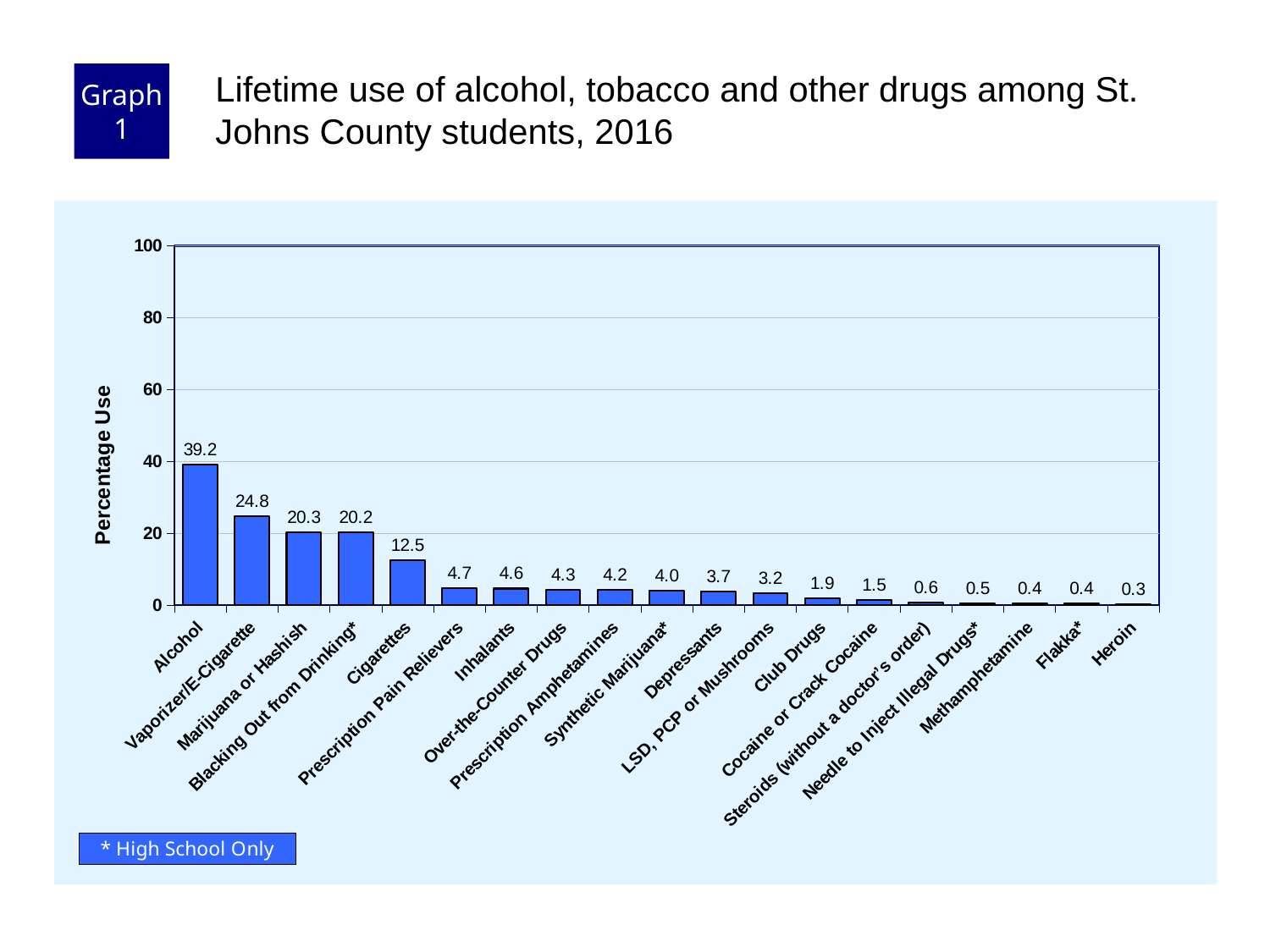
How many categories are shown on the x axis? 19 Which is larger, the value for Cigarettes or the value for Prescription Pain Relievers? Cigarettes What is the value for Alcohol? 39.2 Which category has the highest value? Alcohol What is the value for Cigarettes? 12.5 Do the values rise or fall moving from left to right along the x axis? Fall What is the value for Heroin? 0.3 What kind of chart is shown on the slide? Bar chart What is the difference between the values for Alcohol and Vaporizer/E-Cigarette? 14.4 What is the label of the y axis? Percentage Use What is the value for Vaporizer/E-Cigarette? 24.8 Which category has the lowest value? Heroin